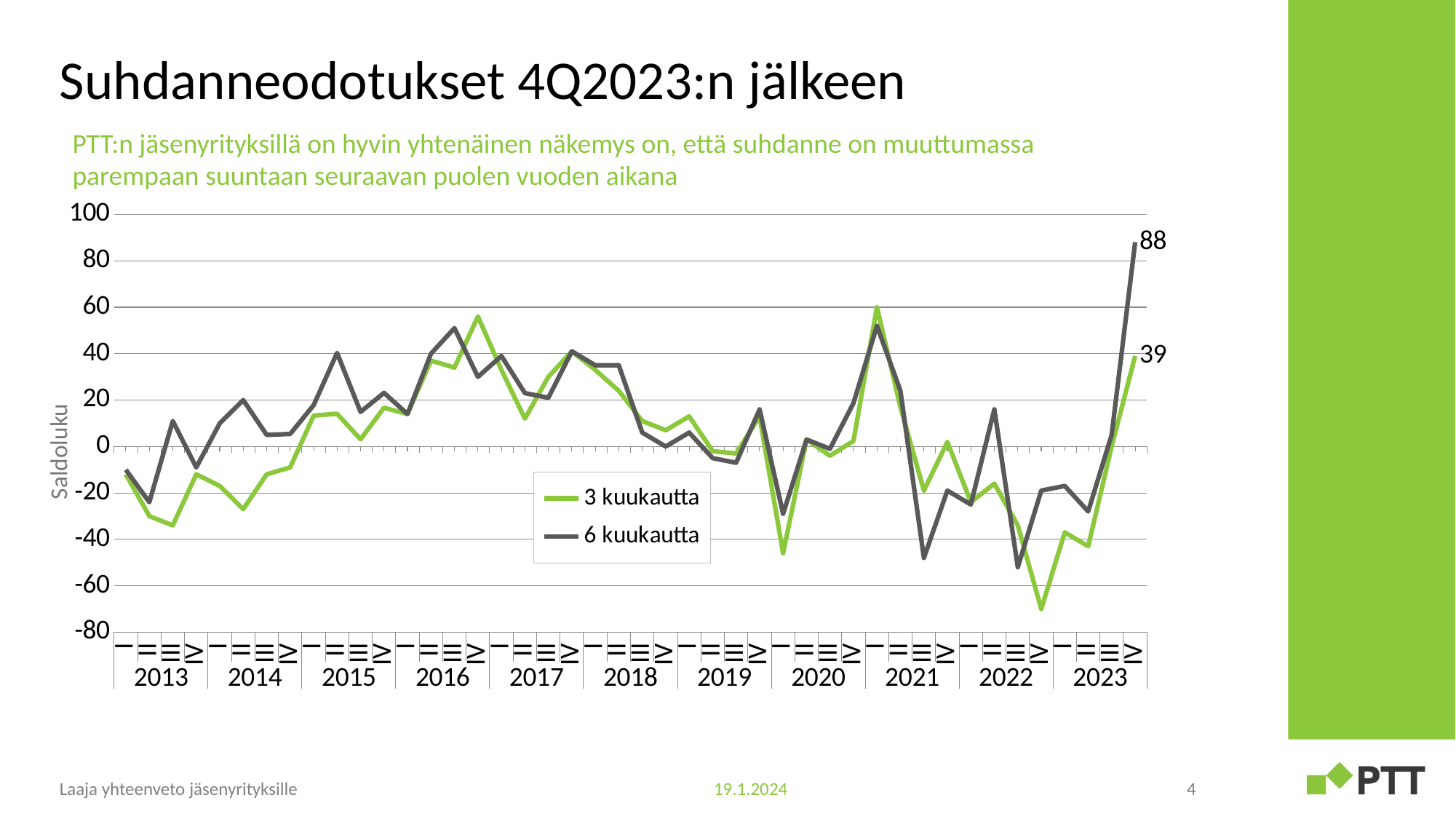
How many series does the legend list? 2 At the last point (IV 2023), which series has the higher value, 3 kuukautta or 6 kuukautta? 6 kuukautta What is the labelled value of the 6 kuukautta series at the last point (IV 2023)? 88 What kind of chart is shown on the slide? line chart What is the difference between the 6 kuukautta and 3 kuukautta values at the last point (IV 2023)? 49 How many years are labelled on the x axis? 11 What is the labelled value of the 3 kuukautta series at the last point (IV 2023)? 39 Is the peak value of the 6 kuukautta series in 2016 greater or less than 40? greater Is the lowest value of the 3 kuukautta series in 2022 greater or less than -60? less Over the course of 2023, does the 6 kuukautta line rise or fall? rise What is the title of the vertical axis? Saldoluku Which series reaches the highest value anywhere on the chart? 6 kuukautta